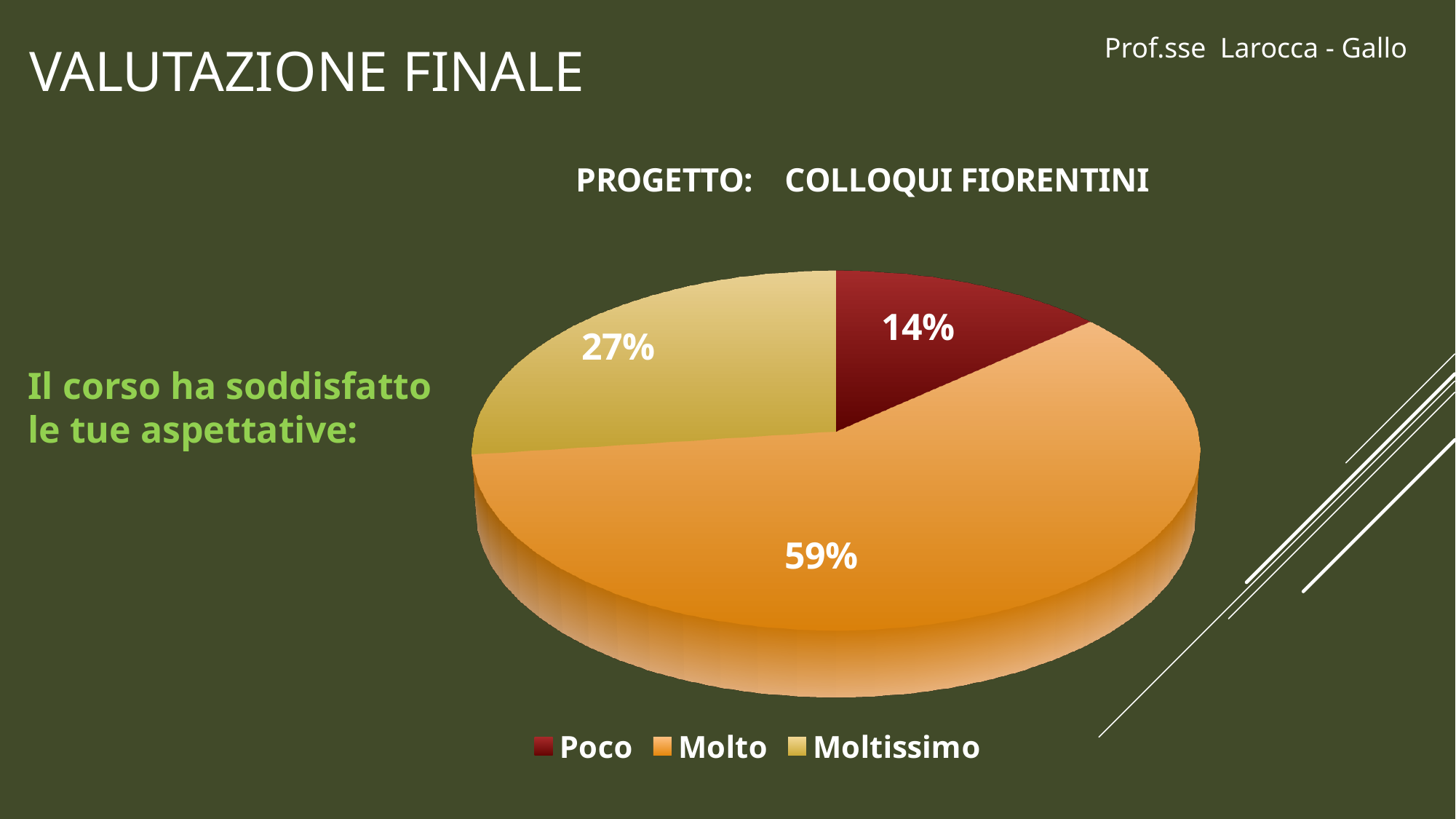
How many categories does the pie chart show? 3 Which category has the largest share of the pie? Molto What kind of chart is shown on the slide? Pie chart Which is larger, the share for "Moltissimo" or the share for "Poco"? Moltissimo Which colour represents "Poco" in the legend? Dark red Which category has the smallest share of the pie? Poco What percentage of respondents answered "Moltissimo"? 27% What is the difference in percentage points between "Moltissimo" and "Poco"? 13 What is the title of the chart? PROGETTO: COLLOQUI FIORENTINI What percentage of respondents answered "Poco"? 14% What is the difference in percentage points between "Molto" and "Moltissimo"? 32 What percentage of respondents answered "Molto"? 59%